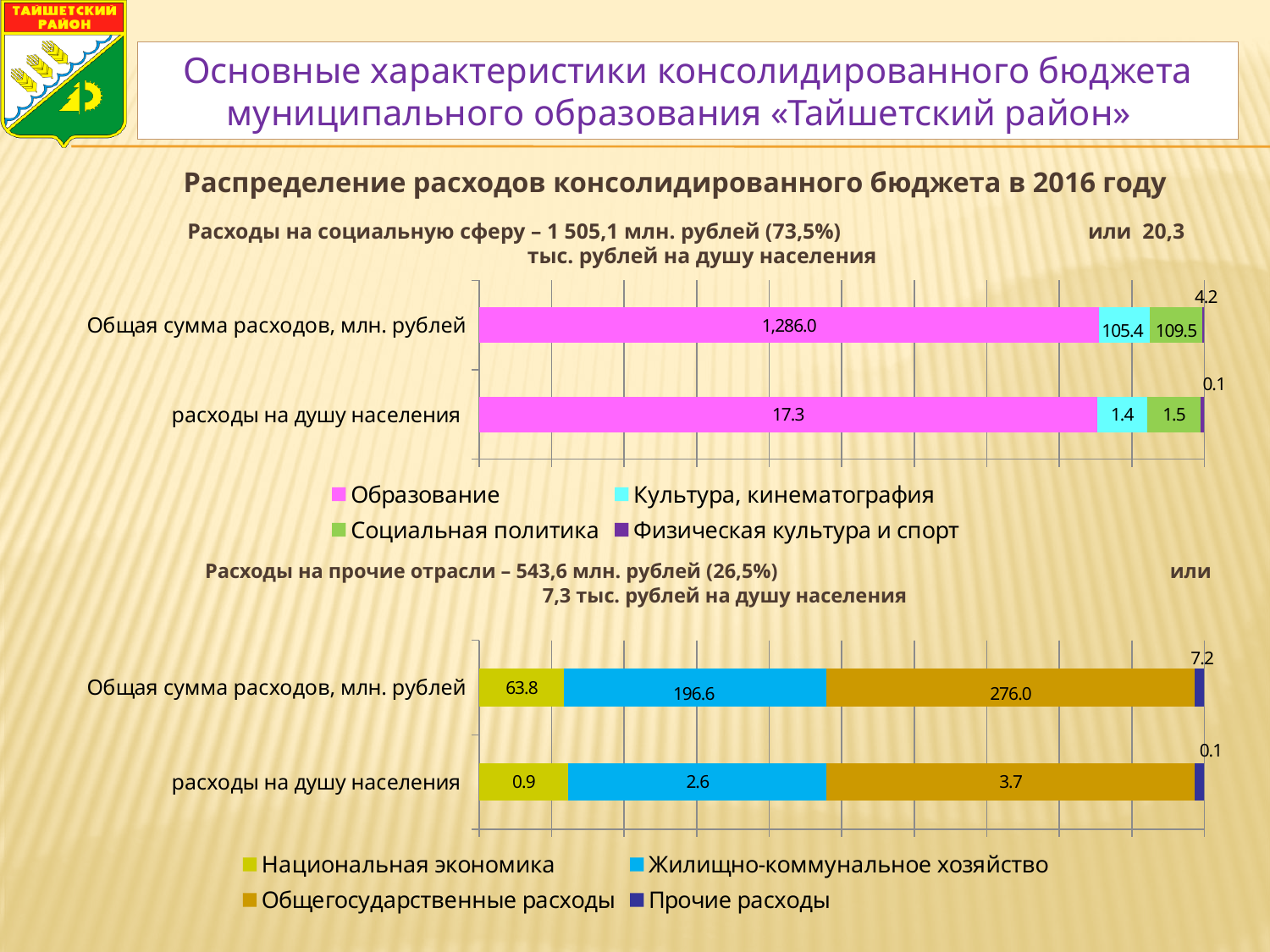
In the bottom chart, what is the value for Жилищно-коммунальное хозяйство in the Общая сумма расходов, млн. рублей bar? 196.6 In the bottom chart, what is the value for Общегосударственные расходы in the расходы на душу населения bar? 3.7 In the bottom chart, what is the total of the Общая сумма расходов, млн. рублей stacked bar? 543.6 What type of chart is the top chart? Stacked bar chart In the top chart, what is the difference between Социальная политика and Культура, кинематография in the Общая сумма расходов, млн. рублей bar? 4.1 In the top chart, what is the value for Образование in the Общая сумма расходов, млн. рублей bar? 1,286.0 In the bottom chart, which is larger in the Общая сумма расходов, млн. рублей bar: Общегосударственные расходы or Жилищно-коммунальное хозяйство? Общегосударственные расходы In the top chart, which series has the largest value in the Общая сумма расходов, млн. рублей bar? Образование How many series does the legend of the bottom chart list? 4 In the top chart, what is the value for Социальная политика in the расходы на душу населения bar? 1.5 In the bottom chart, which series has the smallest value in the Общая сумма расходов, млн. рублей bar? Прочие расходы In the top chart, what is the total of the расходы на душу населения stacked bar? 20.3